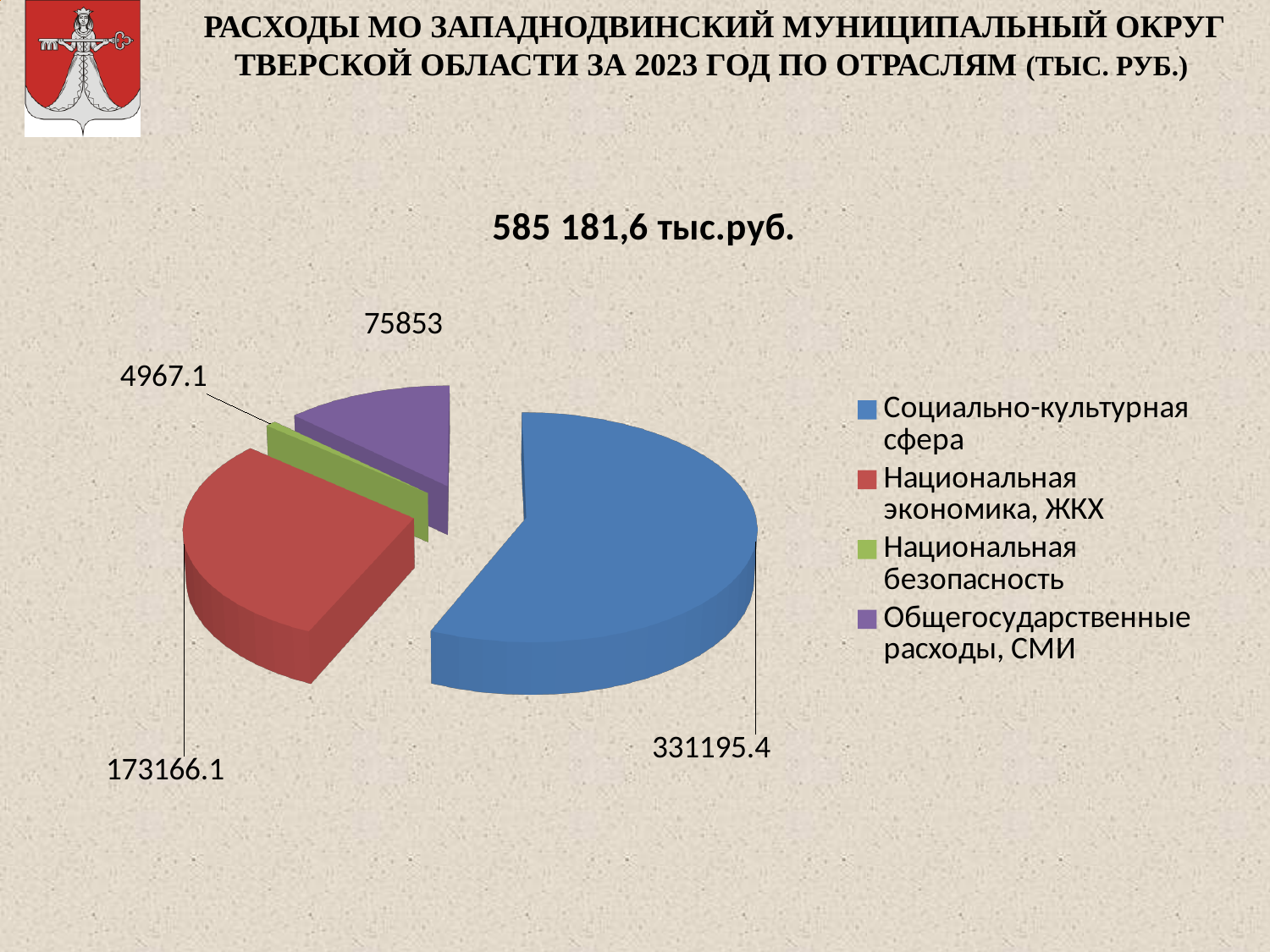
What is the value for Социально-культурная сфера? 331195.4 What is the value for Национальная безопасность? 4967.1 What total amount of expenditure is shown above the pie chart? 585 181,6 тыс.руб. What is the value for Национальная экономика, ЖКХ? 173166.1 What kind of chart is shown on the slide? pie chart Which is larger: Общегосударственные расходы, СМИ or Национальная экономика, ЖКХ? Национальная экономика, ЖКХ What is the difference between the values for Социально-культурная сфера and Национальная экономика, ЖКХ? 158029.3 Which category has the largest slice of the pie? Социально-культурная сфера What is the difference between the values for Общегосударственные расходы, СМИ and Национальная безопасность? 70885.9 Which category has the smallest slice of the pie? Национальная безопасность How many categories does the pie chart show? 4 What is the value for Общегосударственные расходы, СМИ? 75853